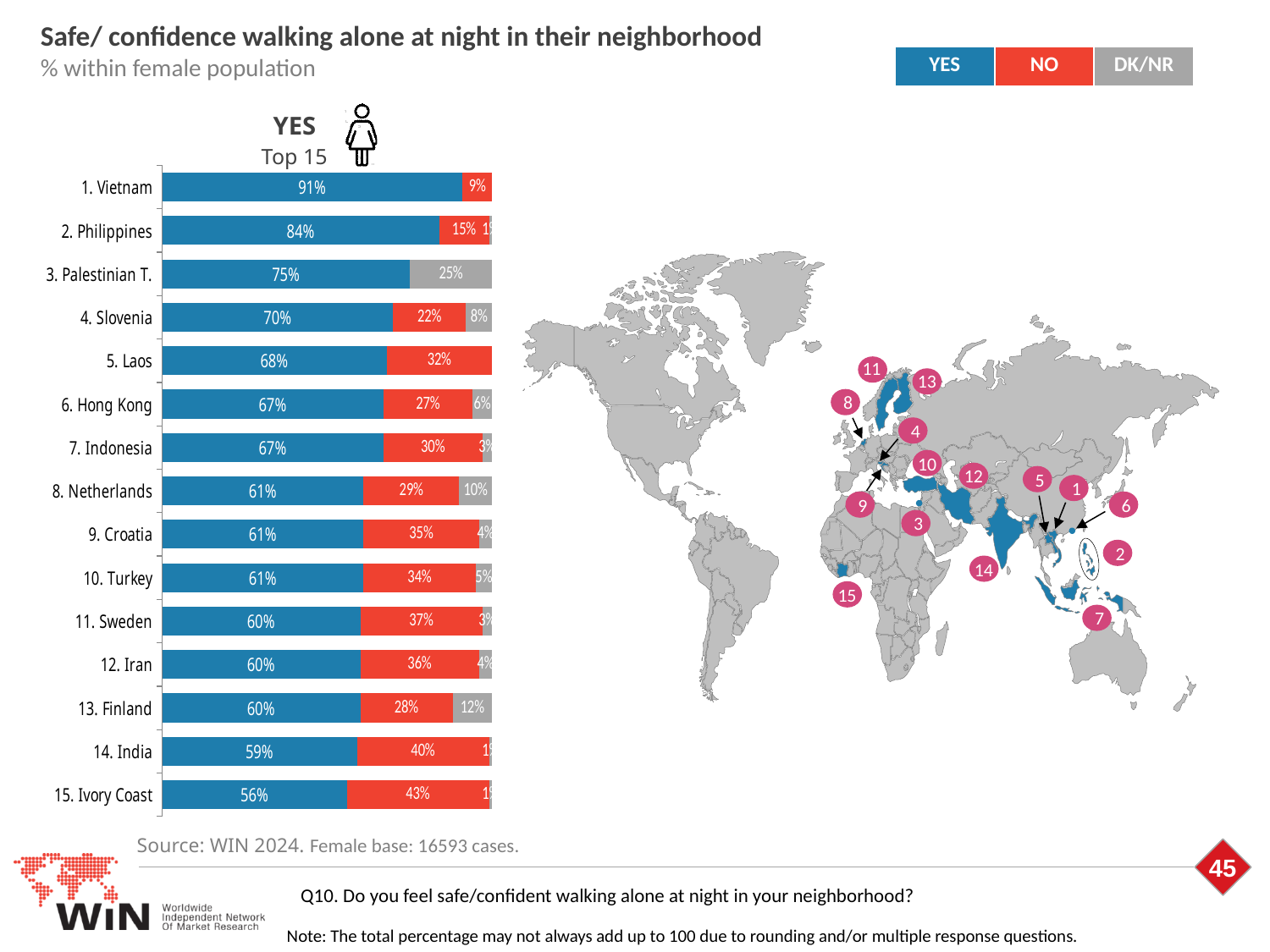
What is the DK/NR value for Finland? 12% Which country has the highest YES value? Vietnam What kind of chart is used to show the country results? Stacked bar chart What is the NO value for Laos? 32% What is the difference between the YES values for Vietnam and Philippines? 7 percentage points How many series does the legend list? 3 What is the NO value for Ivory Coast? 43% Which country has the lowest YES value among the 15 shown? Ivory Coast Which is larger, the NO value for India or the NO value for Sweden? India What is the YES value for Vietnam? 91% How many countries are listed in the bar chart? 15 Which colour represents the NO responses in the chart? Red